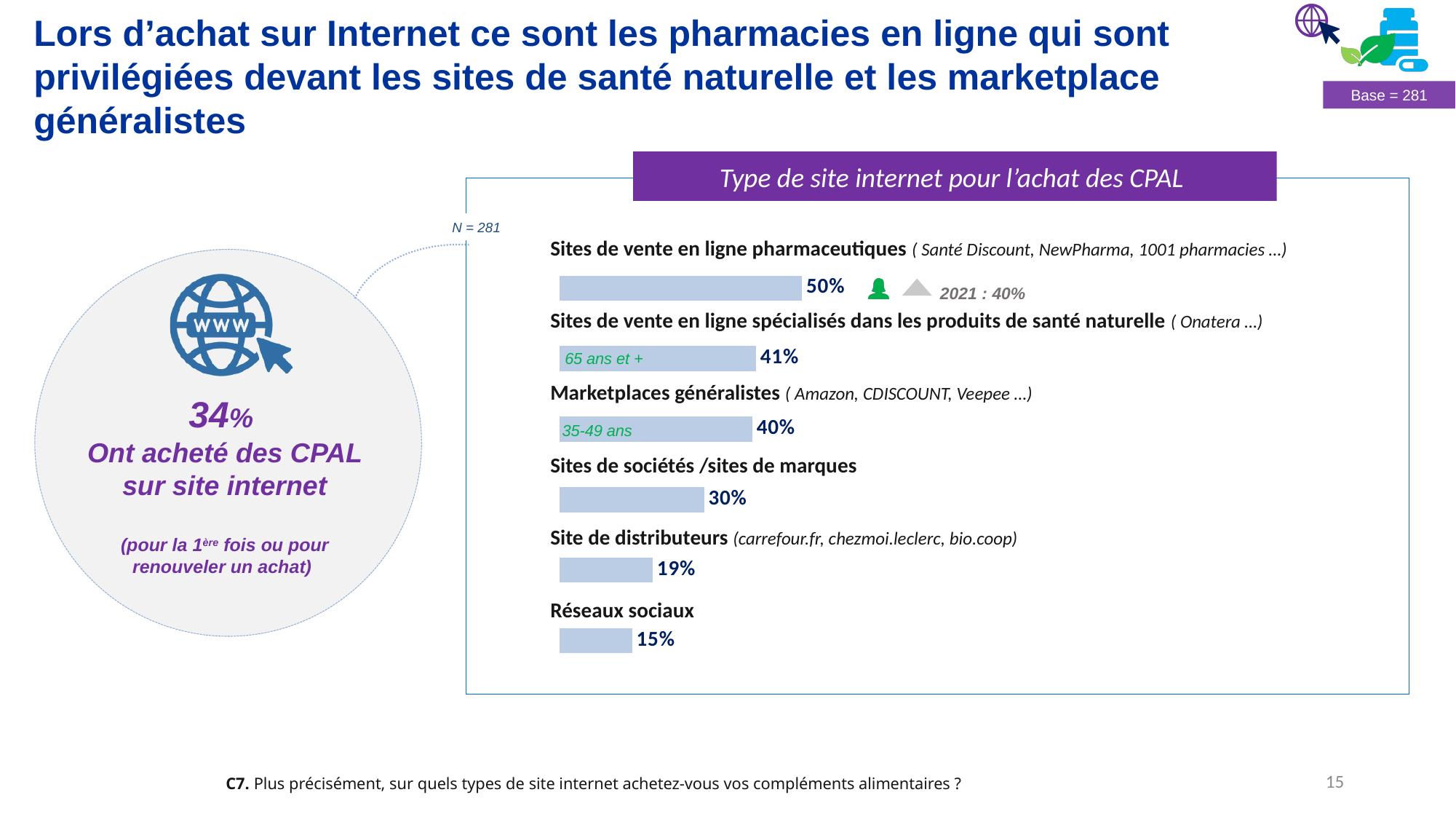
Which is larger: 'Sites de vente en ligne spécialisés dans les produits de santé naturelle' or 'Marketplaces généralistes'? Sites de vente en ligne spécialisés dans les produits de santé naturelle What is the title of the chart? Type de site internet pour l'achat des CPAL What is the difference between 'Sites de vente en ligne pharmaceutiques' and 'Sites de sociétés /sites de marques'? 20% What kind of chart is shown? Bar chart What was the 2021 value shown next to 'Sites de vente en ligne pharmaceutiques'? 40% Which category has the lowest value? Réseaux sociaux What is the value for 'Marketplaces généralistes'? 40% What is the value for 'Site de distributeurs'? 19% What is the value for 'Sites de vente en ligne pharmaceutiques'? 50% Which category has the highest value? Sites de vente en ligne pharmaceutiques What is the value for 'Réseaux sociaux'? 15% How many categories are shown in the chart? 6